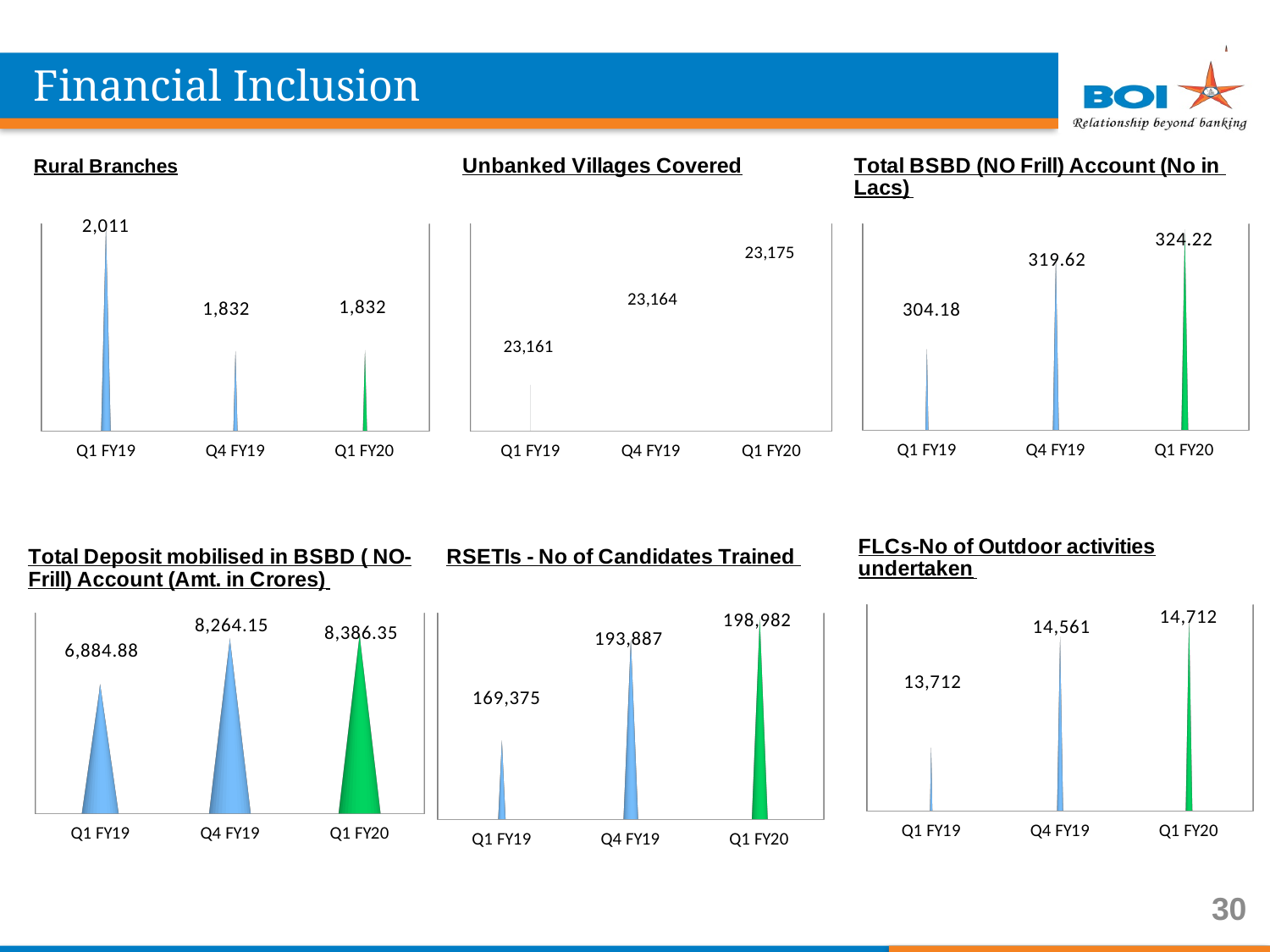
In the RSETIs - No of Candidates Trained chart, which is larger, Q4 FY19 or Q1 FY20? Q1 FY20 In the Total Deposit mobilised in BSBD Account chart, do values rise or fall from Q1 FY19 to Q1 FY20? rise In the Total BSBD (NO Frill) Account chart, which period has the lowest value? Q1 FY19 In the Rural Branches chart, what is the value for Q1 FY19? 2,011 In the Unbanked Villages Covered chart, what is the difference between Q1 FY20 and Q1 FY19? 14 In the Unbanked Villages Covered chart, what is the value for Q1 FY20? 23,175 In the Total Deposit mobilised in BSBD Account chart, what is the value for Q1 FY20? 8,386.35 In the RSETIs - No of Candidates Trained chart, what is the value for Q1 FY19? 169,375 In the Total BSBD (NO Frill) Account chart, what is the value for Q4 FY19? 319.62 In the FLCs-No of Outdoor activities undertaken chart, what is the difference between Q1 FY20 and Q4 FY19? 151 How many periods are shown on the x axis of the FLCs-No of Outdoor activities undertaken chart? 3 In the Rural Branches chart, which period has the highest value? Q1 FY19